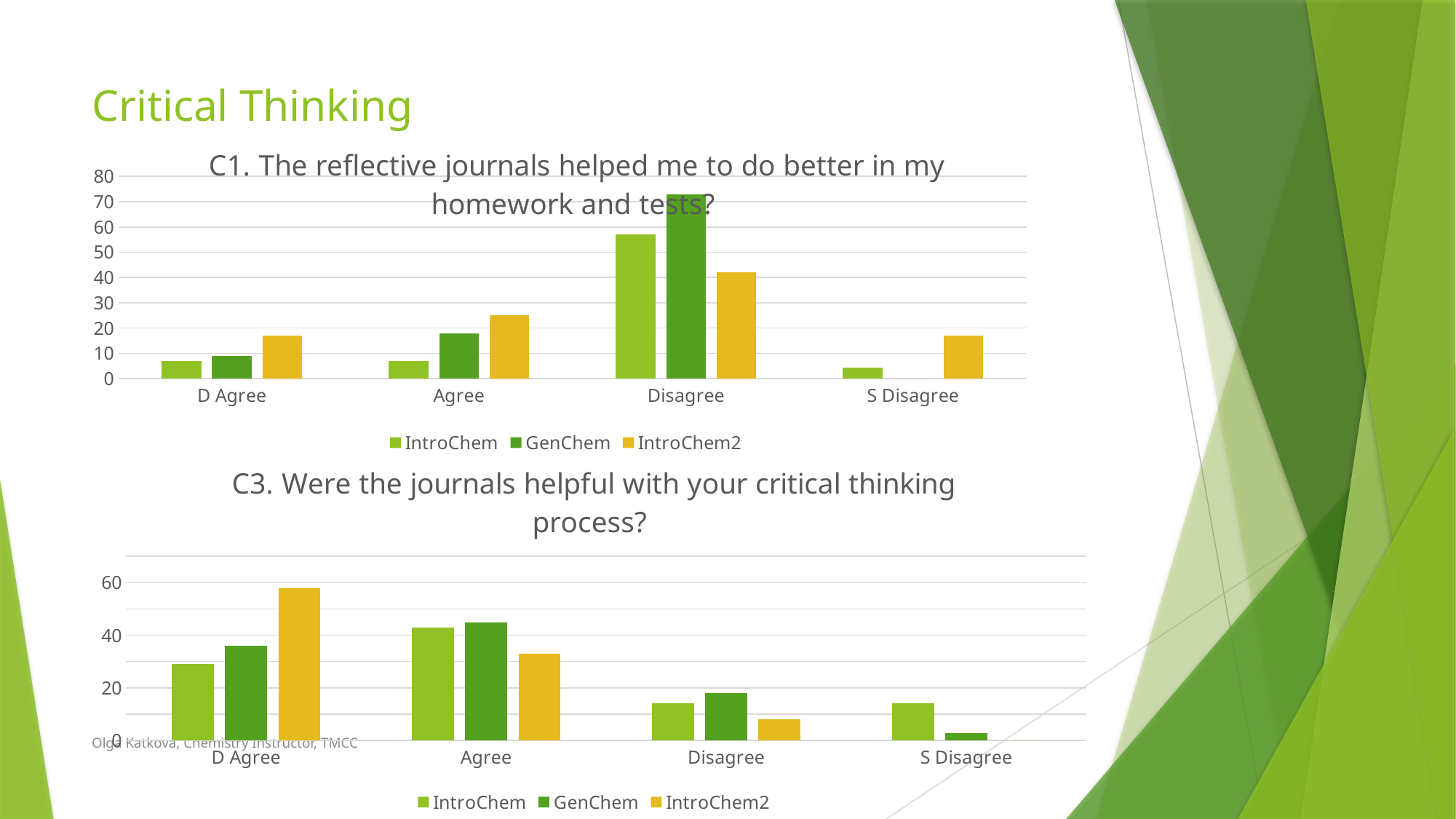
In the chart titled "C3. Were the journals helpful with your critical thinking process?", which category has the highest IntroChem2 value? D Agree In the chart titled "C1. The reflective journals helped me to do better in my homework and tests?", how many categories are shown on the x axis? 4 In the chart titled "C1. The reflective journals helped me to do better in my homework and tests?", how many series does the legend list? 3 In the chart titled "C1. The reflective journals helped me to do better in my homework and tests?", which is larger for S Disagree: IntroChem or IntroChem2? IntroChem2 In the chart titled "C1. The reflective journals helped me to do better in my homework and tests?", which category has the highest GenChem value? Disagree In the chart titled "C3. Were the journals helpful with your critical thinking process?", is the IntroChem2 value for D Agree greater or less than 40? greater In the chart titled "C1. The reflective journals helped me to do better in my homework and tests?", is the GenChem value for Disagree greater or less than 60? greater In the chart titled "C1. The reflective journals helped me to do better in my homework and tests?", what kind of chart is shown? bar chart In the chart titled "C1. The reflective journals helped me to do better in my homework and tests?", is the IntroChem2 value for Disagree greater or less than 30? greater In the chart titled "C3. Were the journals helpful with your critical thinking process?", which is larger for Agree: GenChem or IntroChem2? GenChem In the chart titled "C3. Were the journals helpful with your critical thinking process?", what colour are the IntroChem2 bars? yellow